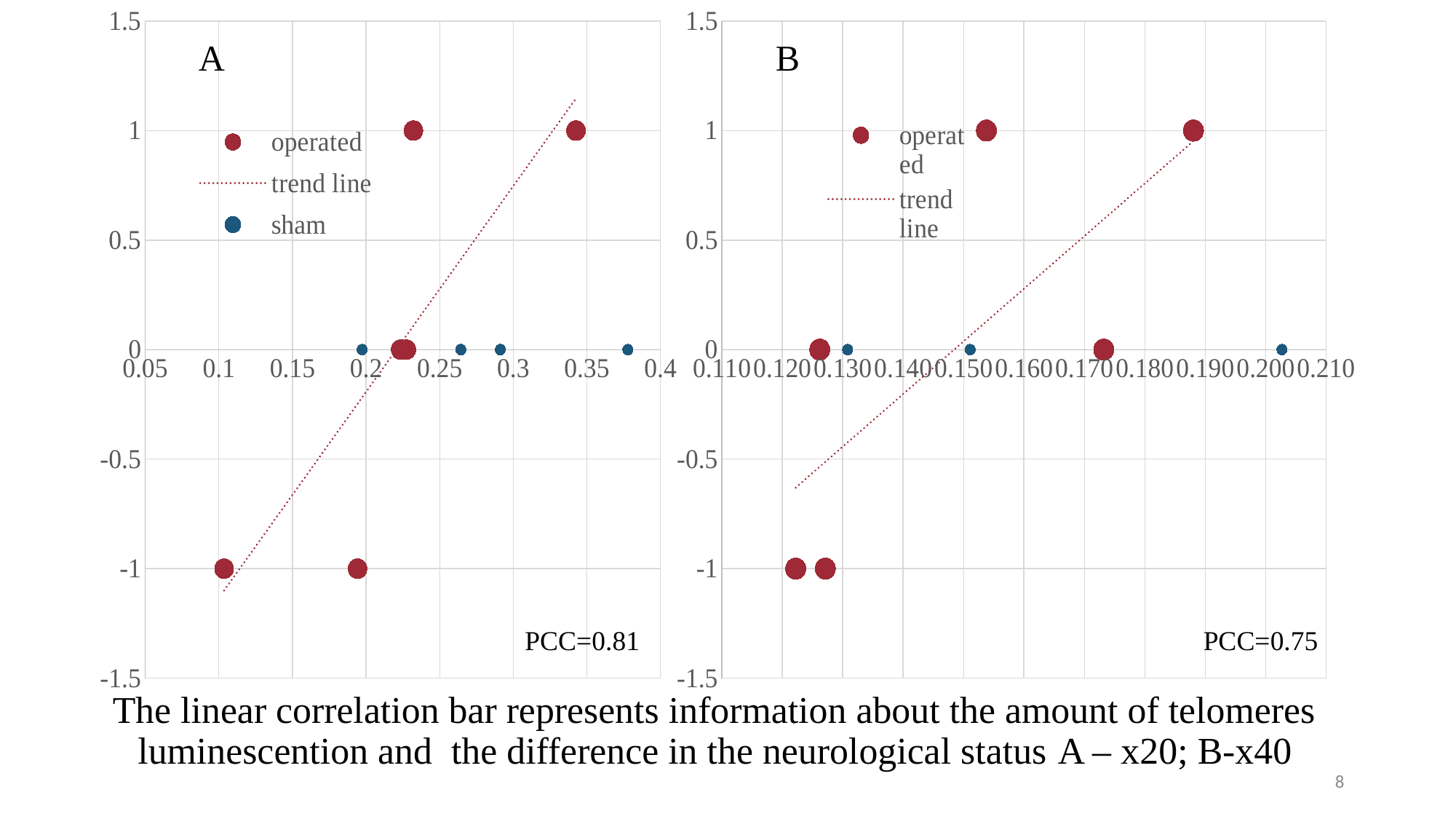
What PCC value is printed on chart A? PCC=0.81 How many entries does the legend of chart A list? 3 In chart A, does the trend line rise or fall from left to right? rise How many entries does the legend of chart B list? 2 In chart A, how many sham (blue) points are plotted? 4 What kind of chart is chart A? scatter chart What PCC value is printed on chart B? PCC=0.75 In chart B, is the x value of the rightmost operated point at y=1 greater or less than 0.180? greater In chart A, is the x value of the leftmost operated point greater or less than 0.15? less What are the names of the legend entries in chart A? operated, trend line, sham Which chart has the higher PCC value, A or B? A What is the difference between the PCC values of chart A and chart B? 0.06